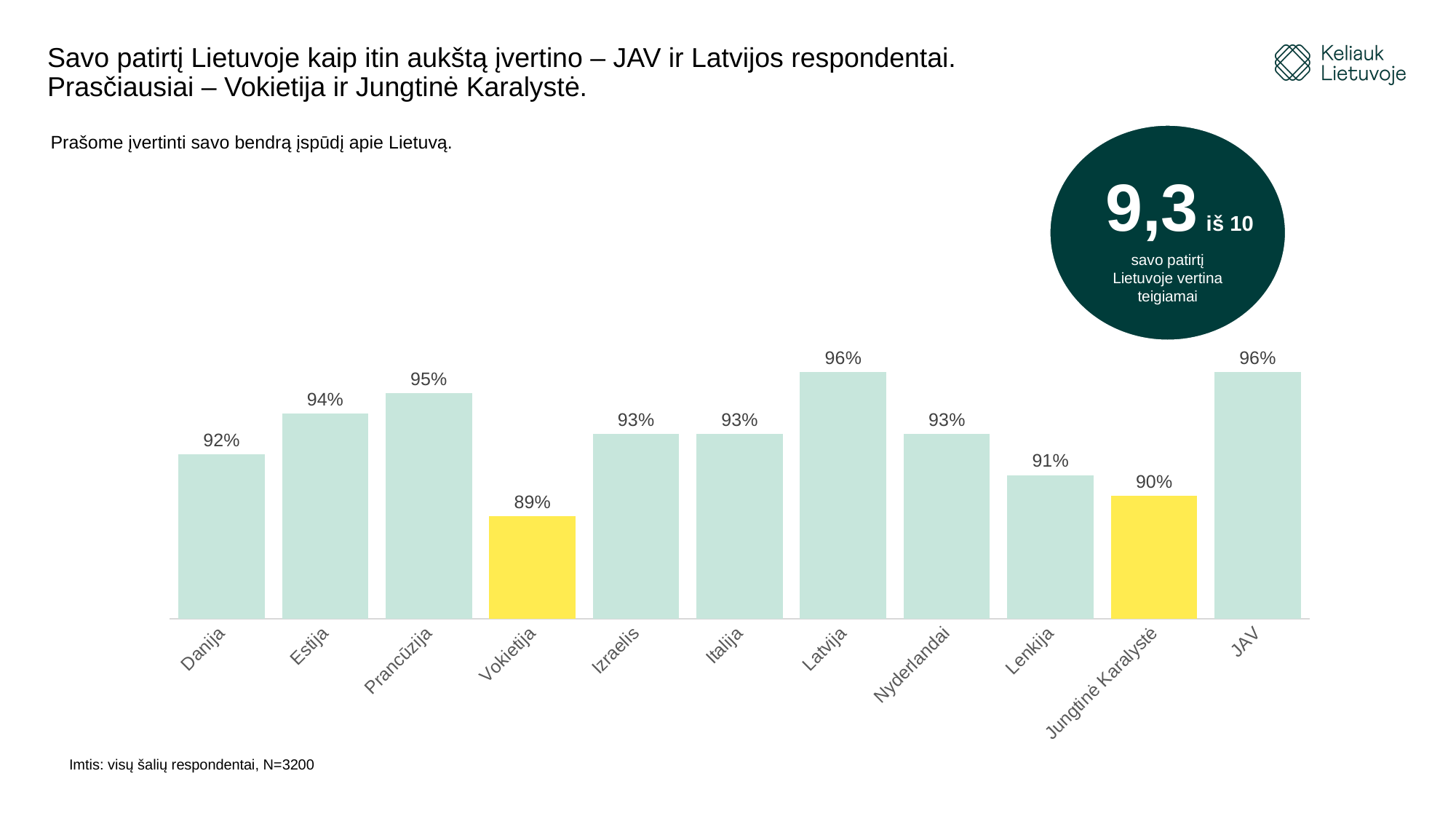
Which two bars are highlighted in yellow? Vokietija and Jungtinė Karalystė What is the difference between the values for Prancūzija and Jungtinė Karalystė? 5 percentage points Which is larger, the value for Estija or the value for Lenkija? Estija What is the value for Danija? 92% Which country has the lowest value in the chart? Vokietija Which two countries share the highest value in the chart? Latvija and JAV What is the value for Jungtinė Karalystė? 90% What is the value for Vokietija? 89% What is the value for Lenkija? 91% How many countries are shown in the bar chart? 11 What type of chart is shown on the slide? Bar chart What is the difference between the values for Latvija and Vokietija? 7 percentage points